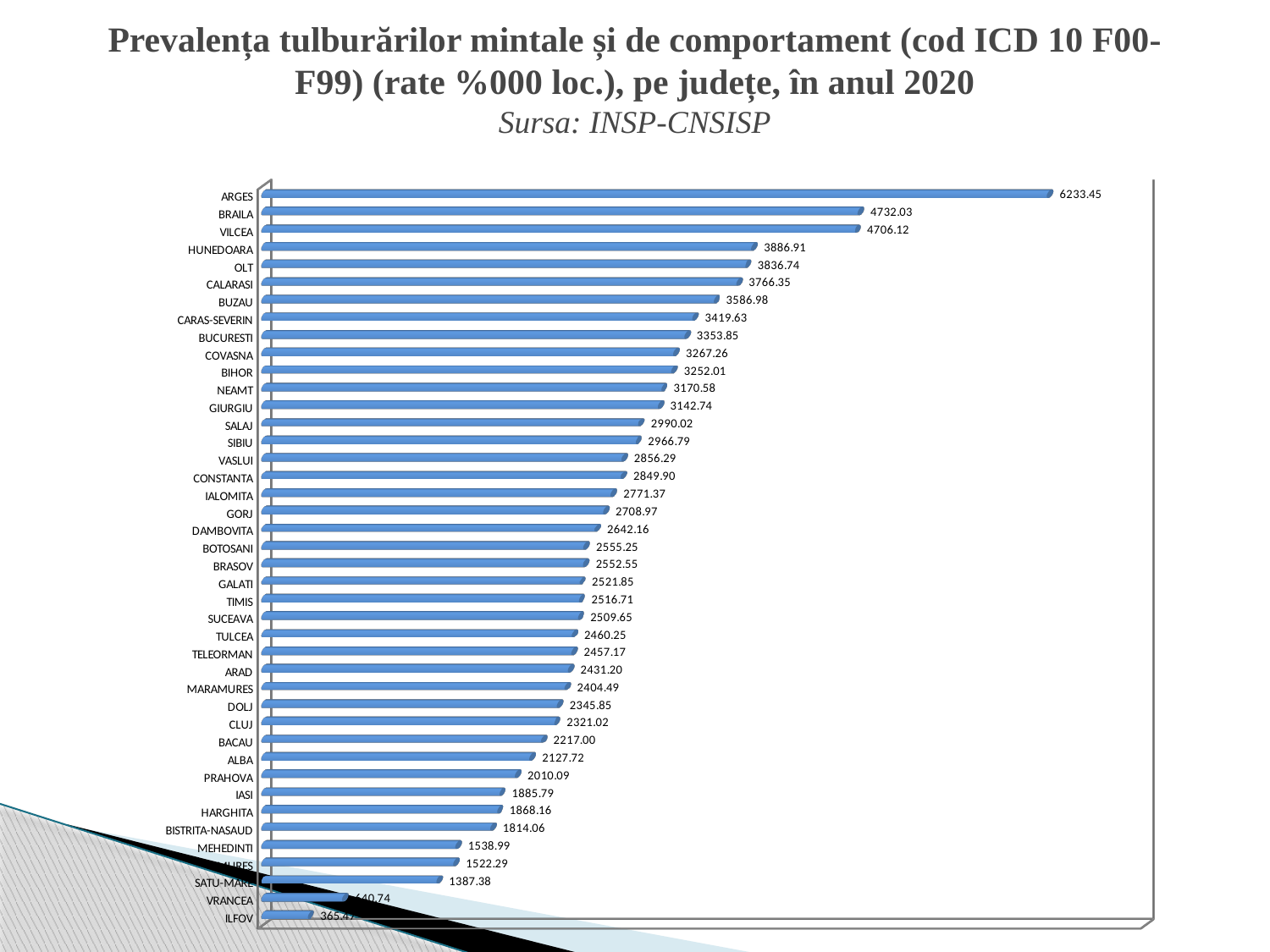
Which county has the highest value? ARGES What is the value for MEHEDINTI? 1538.99 How many counties are shown in the chart? 42 What kind of chart is shown on the slide? Bar chart What source is cited under the chart title? INSP-CNSISP What is the value for CLUJ? 2321.02 What is the value for BUCURESTI? 3353.85 Which has a larger value, BUZAU or CARAS-SEVERIN? BUZAU Which county has the lowest value? ILFOV What is the difference between the values for ARGES and BRAILA? 1501.42 What is the value for ARGES? 6233.45 What is the difference between the values for HUNEDOARA and OLT? 50.17